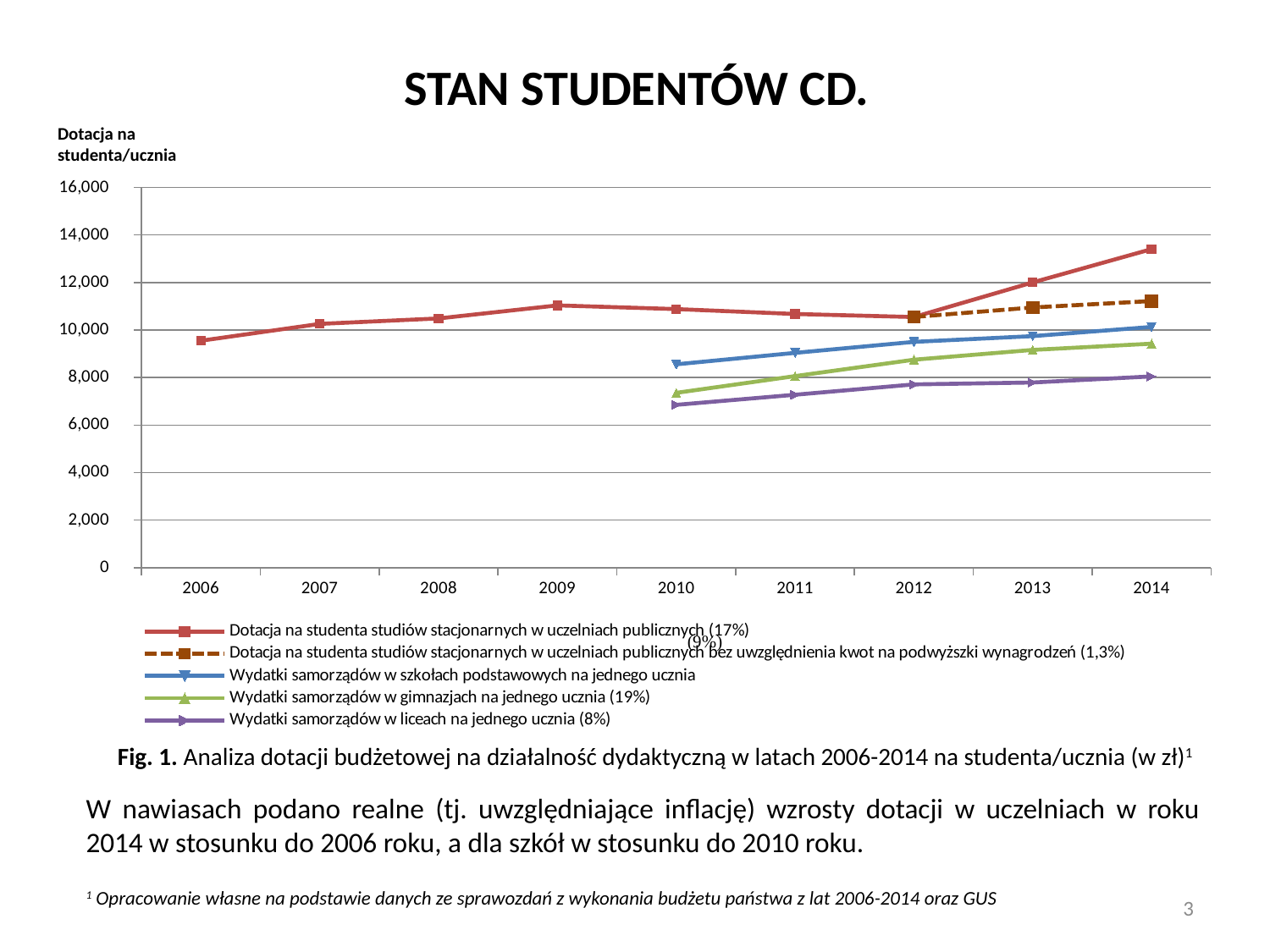
Is the 2014 value for 'Dotacja na studenta studiów stacjonarnych w uczelniach publicznych (17%)' greater or less than 12,000? greater Which series has the lowest value in 2014? Wydatki samorządów w liceach na jednego ucznia (8%) Is the 2006 value for 'Dotacja na studenta studiów stacjonarnych w uczelniach publicznych (17%)' greater or less than 10,000? less In 2014, which is larger: the solid red line 'Dotacja na studenta studiów stacjonarnych w uczelniach publicznych (17%)' or the dashed line 'bez uwzględnienia kwot na podwyżki wynagrodzeń (1,3%)'? Dotacja na studenta studiów stacjonarnych w uczelniach publicznych (17%) How many years are shown on the x axis of the chart? 9 How many series does the chart legend list? 5 Which series has the highest value in 2014? Dotacja na studenta studiów stacjonarnych w uczelniach publicznych (17%) Is the 2010 value for 'Wydatki samorządów w szkołach podstawowych na jednego ucznia' greater or less than 8,000? greater Does the value for 'Dotacja na studenta studiów stacjonarnych w uczelniach publicznych (17%)' rise or fall from 2012 to 2014? rise What kind of chart is shown on the slide? line chart What is the label shown above the y axis of the chart? Dotacja na studenta/ucznia